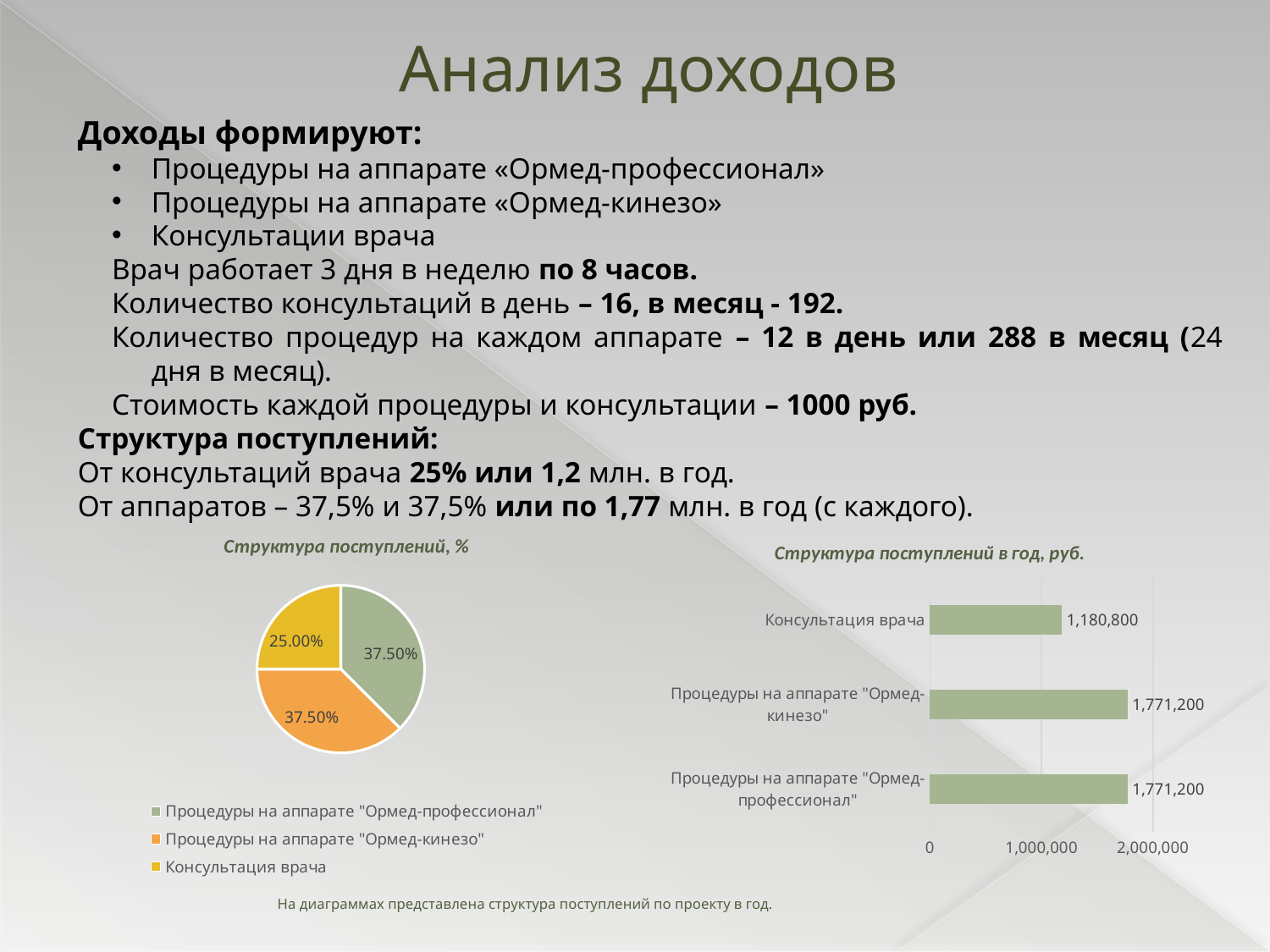
In the chart titled "Структура поступлений, %", how many entries does the legend list? 3 In the chart titled "Структура поступлений в год, руб.", what is the value for Консультация врача? 1,180,800 In the chart titled "Структура поступлений, %", which slice is the smallest? Консультация врача In the chart titled "Структура поступлений в год, руб.", which category has the lowest value? Консультация врача In the chart titled "Структура поступлений, %", what share does Процедуры на аппарате "Ормед-кинезо" have? 37.50% What kind of chart is the chart titled "Структура поступлений, %"? pie chart In the chart titled "Структура поступлений в год, руб.", what is the value for Процедуры на аппарате "Ормед-кинезо"? 1,771,200 In the chart titled "Структура поступлений в год, руб.", is the value for Консультация врача greater or less than 1,000,000? greater In the chart titled "Структура поступлений в год, руб.", what is the difference between the value for Процедуры на аппарате "Ормед-профессионал" and the value for Консультация врача? 590,400 In the chart titled "Структура поступлений, %", what share does Консультация врача have? 25.00% In the chart titled "Структура поступлений в год, руб.", how many categories are shown? 3 What kind of chart is the chart titled "Структура поступлений в год, руб."? bar chart